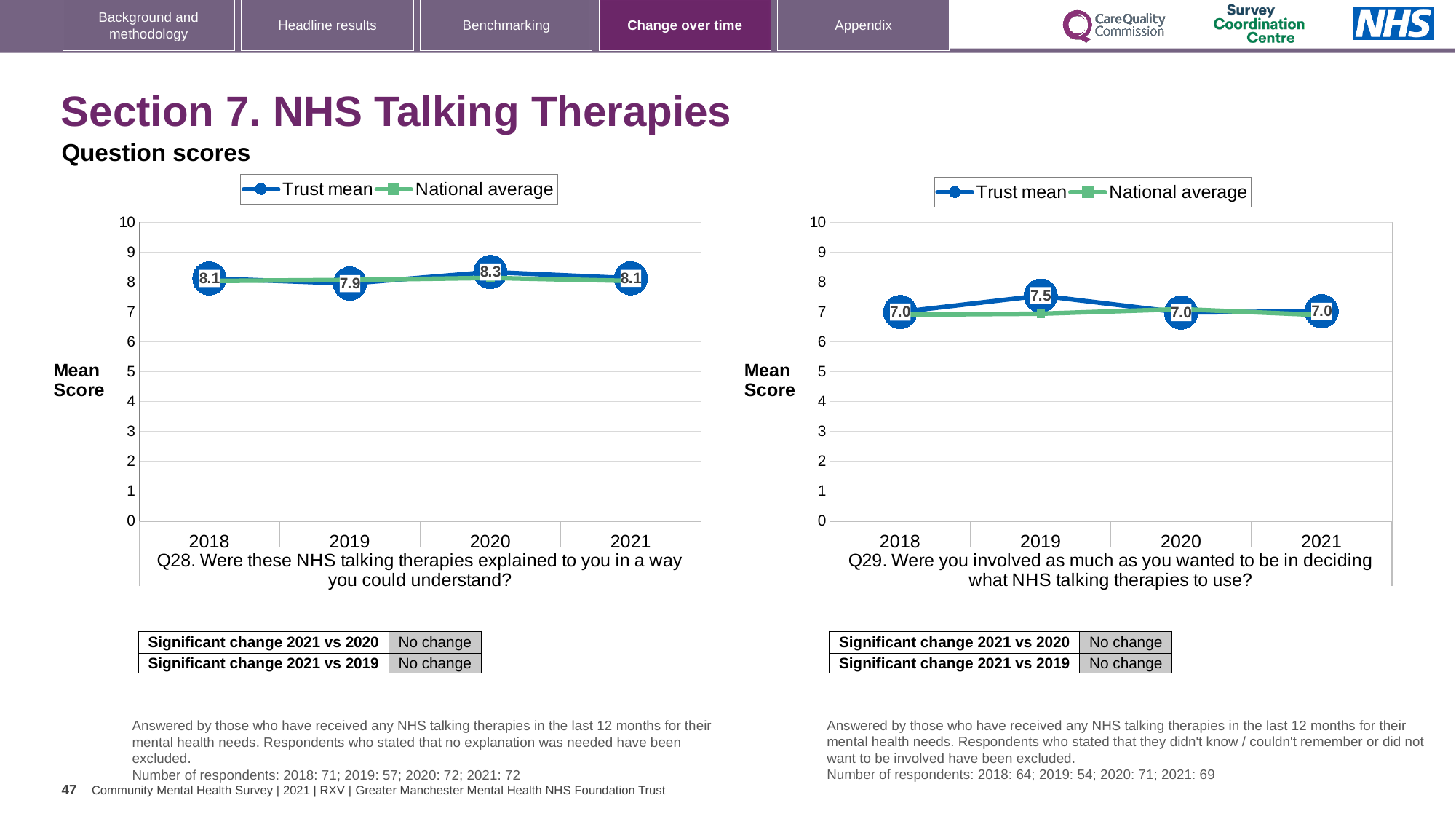
In the Q28 chart on the left, which year has the highest Trust mean score? 2020 In the Q28 chart on the left, what is the difference between the Trust mean scores for 2020 and 2019? 0.4 How many years are plotted on the x axis of the Q28 chart on the left? 4 In the Q29 chart on the right, what is the difference between the Trust mean scores for 2019 and 2021? 0.5 How many series does the legend of the Q29 chart on the right list? 2 In the Q29 chart on the right, which year has the highest Trust mean score? 2019 In the Q29 chart on the right, is the Trust mean score for 2018 greater or less than 8? less In the Q28 chart on the left, what is the Trust mean score for 2019? 7.9 In the Q28 chart on the left, what is the Trust mean score for 2020? 8.3 In the Q29 chart on the right, what is the Trust mean score for 2019? 7.5 In the Q28 chart on the left, which year has the lowest Trust mean score? 2019 What type of chart is the Q28 chart on the left? Line chart